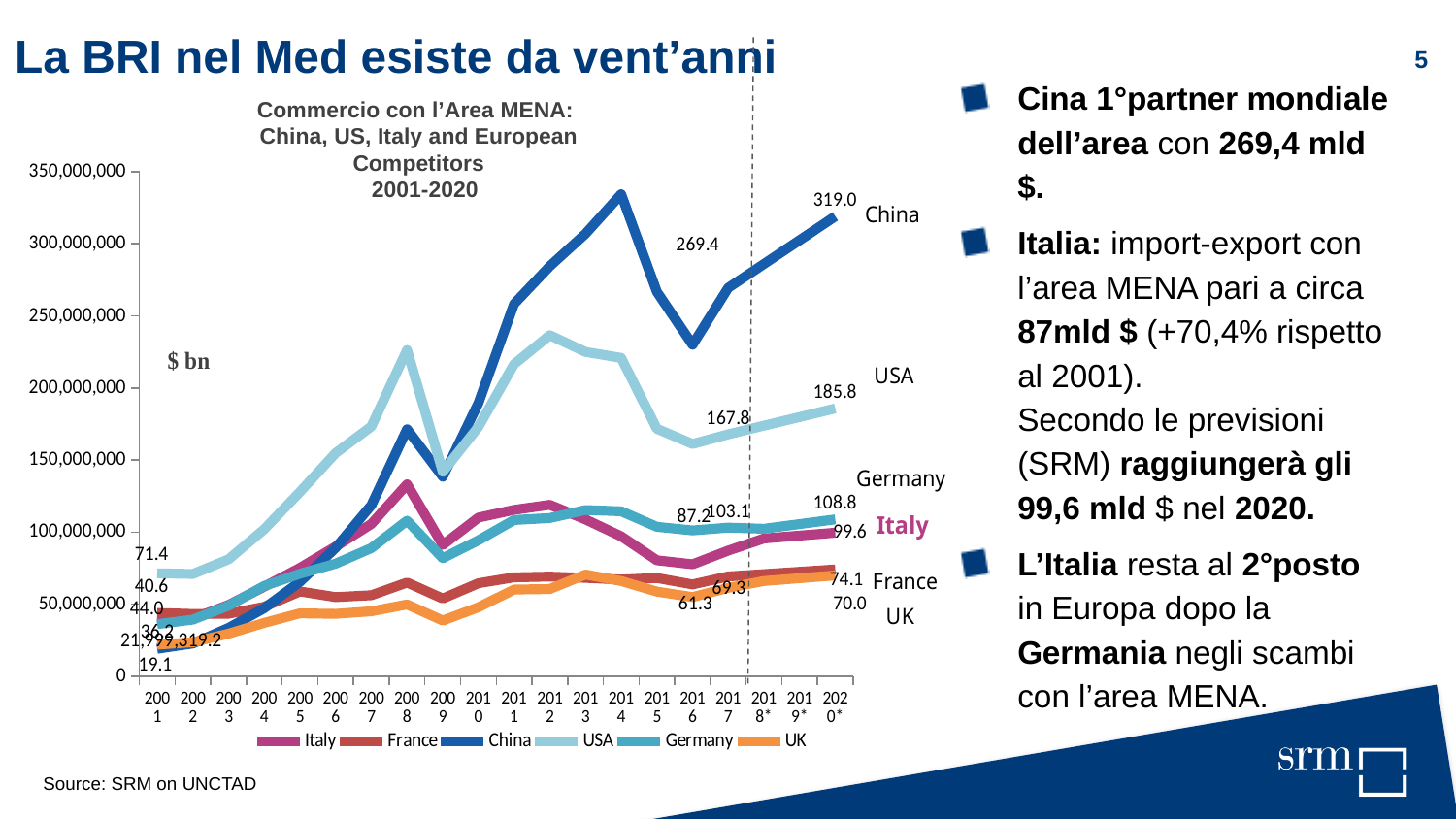
Which series has the highest value at 2020* in the chart? China Is the value for China in 2014 greater or less than 300,000,000? greater What kind of chart is shown on the slide? line chart What is the title of the chart? Commercio con l'Area MENA: China, US, Italy and European Competitors 2001-2020 What is the difference between the China and USA values labelled at 2020*? 133.2 What is the value labelled for Italy at 2020* in the chart? 99.6 What is the value labelled for USA at 2020* in the chart? 185.8 How many series does the legend of the chart list? 6 What is the value labelled for China at 2020* in the chart? 319.0 Which series has the lowest value at 2020* in the chart? UK What is the value labelled for Germany at 2020* in the chart? 108.8 At 2020*, which is larger: the value for Germany or the value for Italy? Germany